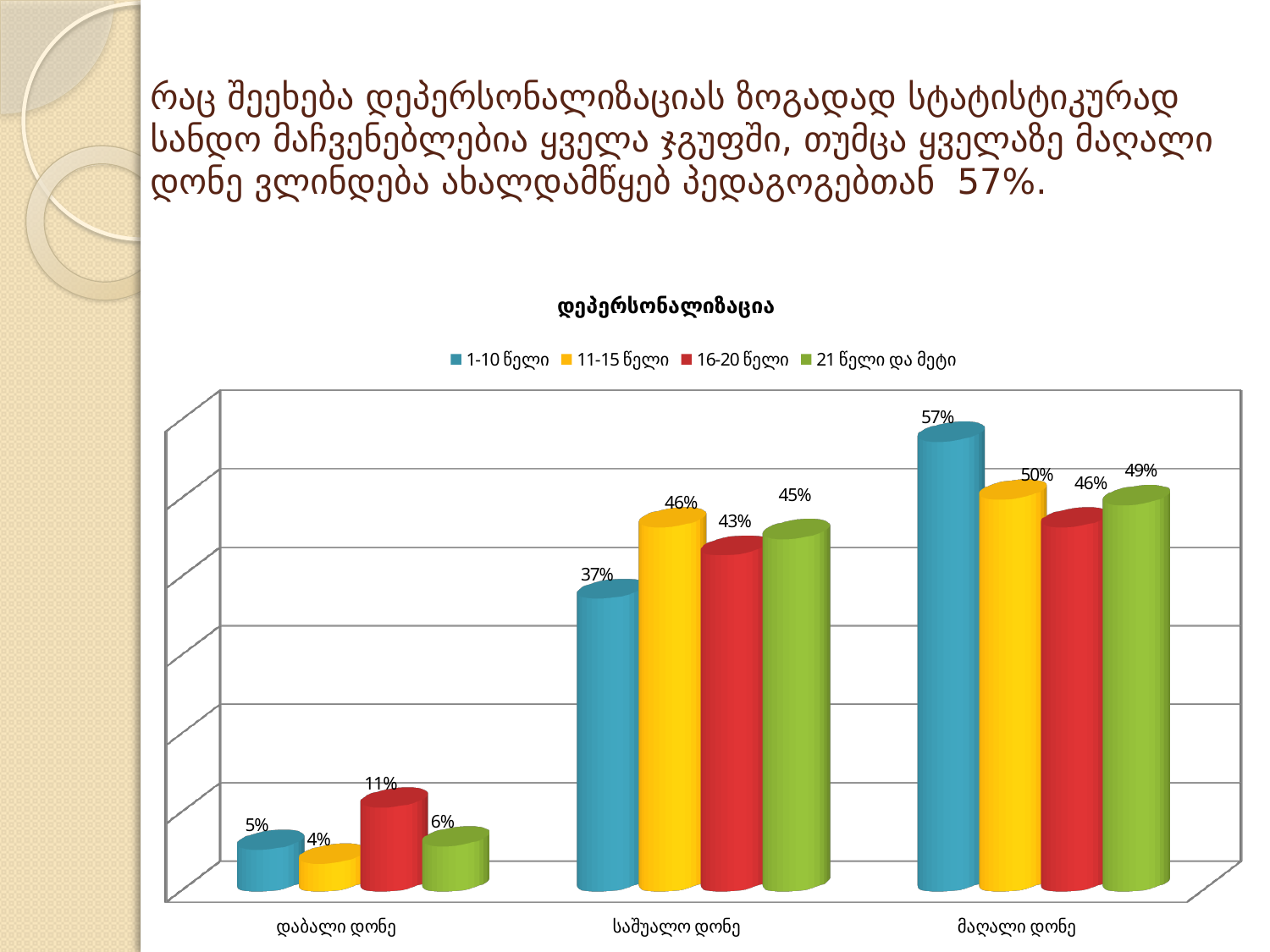
What is the title of the chart? დეპერსონალიზაცია What kind of chart is shown on the slide? Bar chart Which is larger in the საშუალო დონე category: the value for 16-20 წელი or the value for 21 წელი და მეტი? 21 წელი და მეტი How many categories are shown on the x axis? 3 What is the difference between the 1-10 წელი value and the 11-15 წელი value in the მაღალი დონე category? 7% What is the value for 16-20 წელი in the დაბალი დონე category? 11% What is the value for 1-10 წელი in the მაღალი დონე category? 57% What is the value for 21 წელი და მეტი in the საშუალო დონე category? 45% Which series has the highest value in the საშუალო დონე category? 11-15 წელი Which series has the lowest value in the დაბალი დონე category? 11-15 წელი What is the value for 11-15 წელი in the მაღალი დონე category? 50% How many series does the legend list? 4